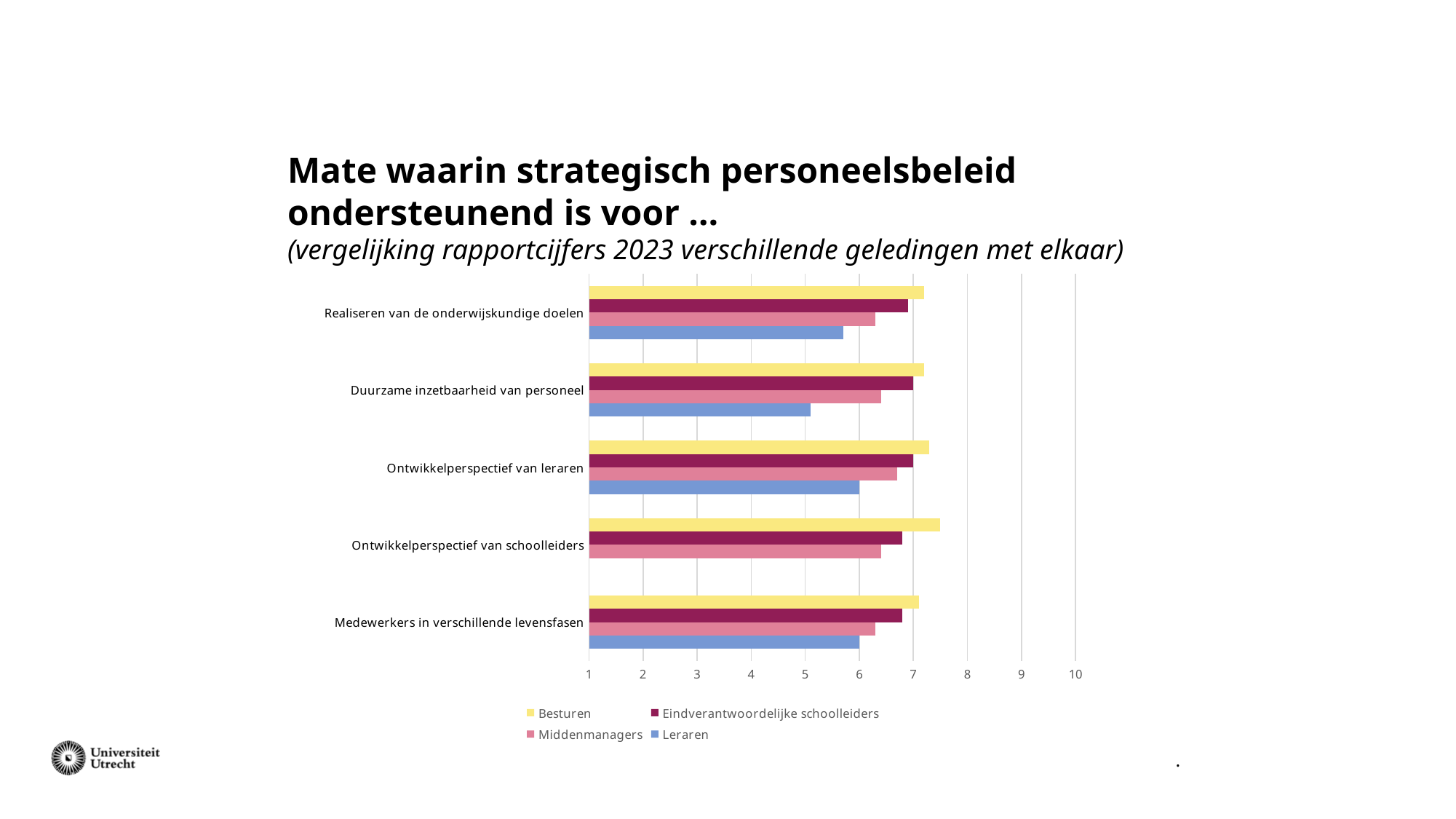
Which series is shown in blue in the legend? Leraren Which series has the highest value in every category of the chart? Besturen How many series does the legend list? 4 Which is larger for 'Duurzame inzetbaarheid van personeel': the value for Besturen or the value for Leraren? Besturen Is the value for Besturen on 'Realiseren van de onderwijskundige doelen' greater or less than 7? greater Is the value for Leraren on 'Duurzame inzetbaarheid van personeel' greater or less than 6? less Is the value for Besturen on 'Ontwikkelperspectief van schoolleiders' greater or less than 7? greater Which is larger for 'Medewerkers in verschillende levensfasen': the value for Eindverantwoordelijke schoolleiders or the value for Leraren? Eindverantwoordelijke schoolleiders For which category is the Leraren value the lowest? Duurzame inzetbaarheid van personeel How many categories are shown on the vertical axis of the chart? 5 What kind of chart is shown on the slide? bar chart